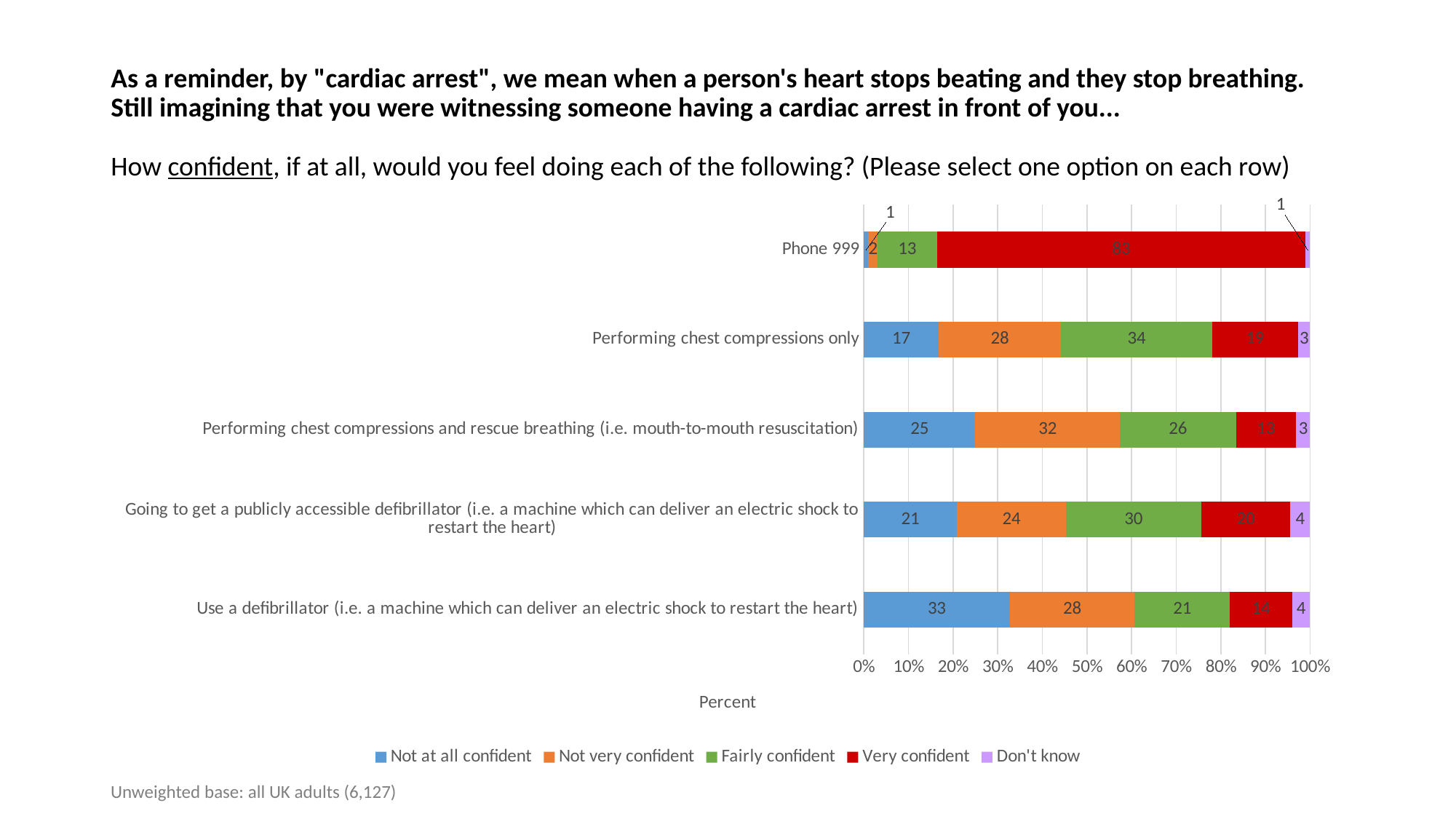
How many categories (actions) are plotted on the chart? 5 What is the 'Not very confident' value for 'Performing chest compressions and rescue breathing'? 32 What is the 'Don't know' value for 'Going to get a publicly accessible defibrillator'? 4 What percentage of respondents are 'Not at all confident' about using a defibrillator? 33 What kind of chart is shown on the slide? stacked bar chart How many series does the legend list? 5 Which action has the lowest 'Not at all confident' value? Phone 999 What is the 'Fairly confident' value for 'Performing chest compressions only'? 34 Which series is shown in red in the legend? Very confident Which action has the highest 'Not at all confident' value? Use a defibrillator Which is larger: the 'Very confident' value for 'Going to get a publicly accessible defibrillator' or for 'Use a defibrillator'? Going to get a publicly accessible defibrillator What is the difference between the 'Not at all confident' values for 'Use a defibrillator' and 'Performing chest compressions only'? 16